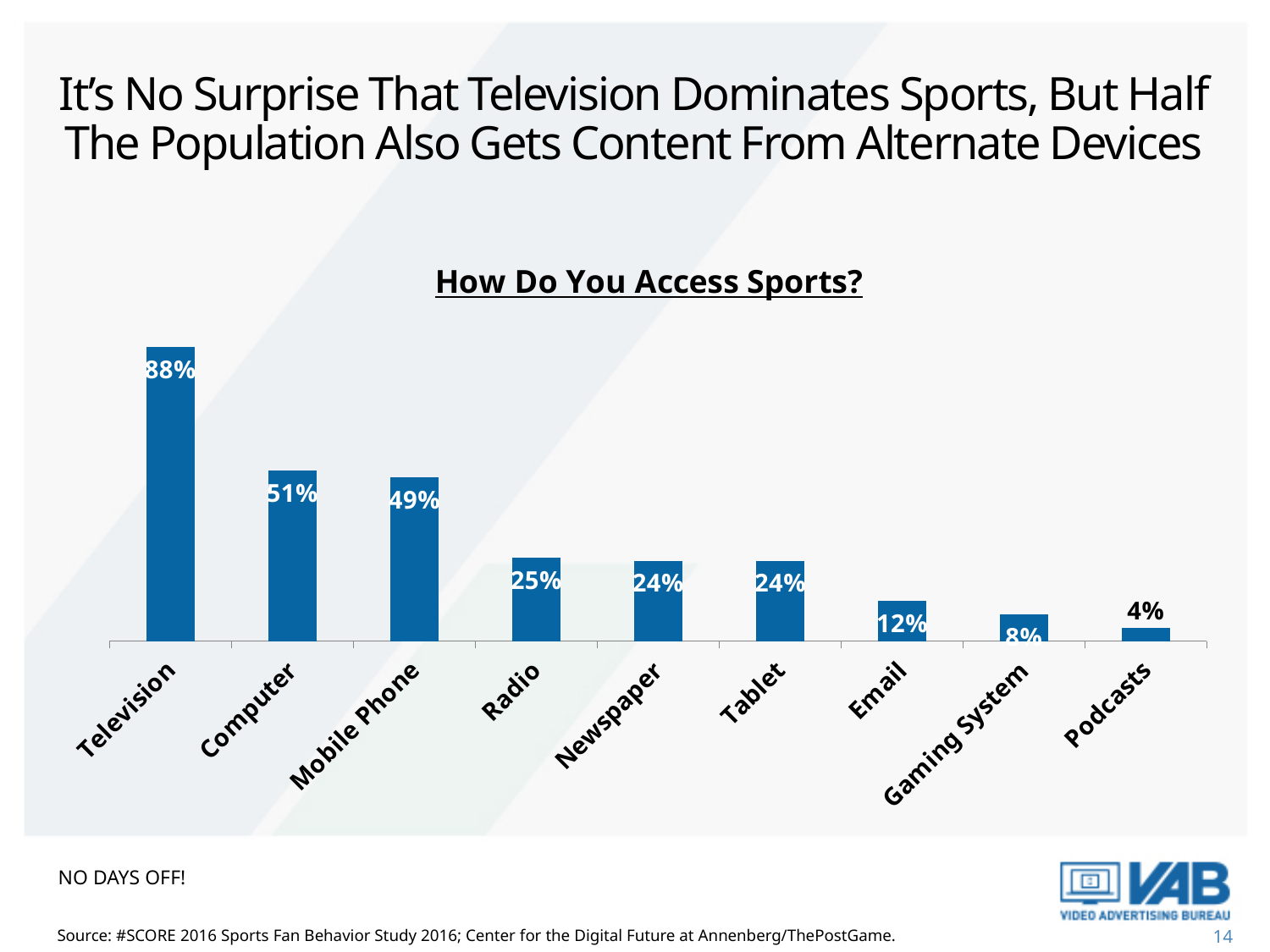
Which category has the lowest value? Podcasts What is the value for Podcasts? 4% How many categories are shown in the chart? 9 Which is larger, the value for Computer or the value for Radio? Computer What type of chart is shown? Bar chart What is the value for Mobile Phone? 49% What percentage of respondents access sports via Television? 88% What is the value for Email? 12% Which category has the highest value? Television What is the difference between the values for Radio and Gaming System? 17% What is the difference between the values for Television and Computer? 37% What is the title of the chart? How Do You Access Sports?